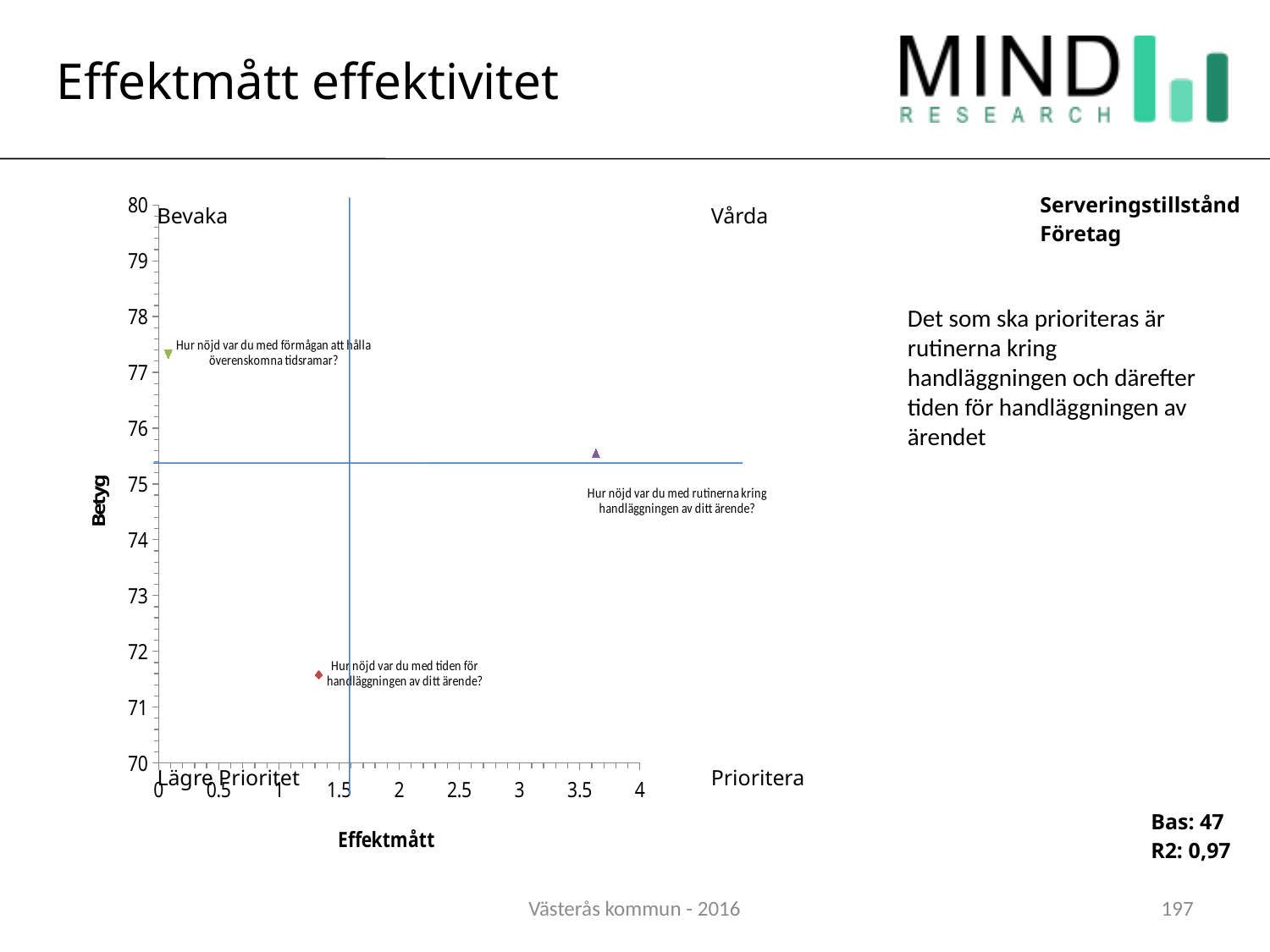
Which point has the highest Effektmått value? Hur nöjd var du med rutinerna kring handläggningen av ditt ärende? How many data points are plotted in the chart? 3 Is the Betyg value for 'Hur nöjd var du med tiden för handläggningen av ditt ärende?' greater or less than 72? less Which point has the lowest Betyg value? Hur nöjd var du med tiden för handläggningen av ditt ärende? Which point has the highest Betyg value? Hur nöjd var du med förmågan att hålla överenskomna tidsramar? What is the title of the y axis of the chart? Betyg Is the Betyg value for 'Hur nöjd var du med förmågan att hålla överenskomna tidsramar?' greater or less than 77? greater Which has a higher Betyg value: 'Hur nöjd var du med rutinerna kring handläggningen av ditt ärende?' or 'Hur nöjd var du med tiden för handläggningen av ditt ärende?'? Hur nöjd var du med rutinerna kring handläggningen av ditt ärende? Which point has the lowest Effektmått value? Hur nöjd var du med förmågan att hålla överenskomna tidsramar? Is the Effektmått value for 'Hur nöjd var du med rutinerna kring handläggningen av ditt ärende?' greater or less than 3.5? greater What is the title of the x axis of the chart? Effektmått What kind of chart is shown on the slide? scatter chart